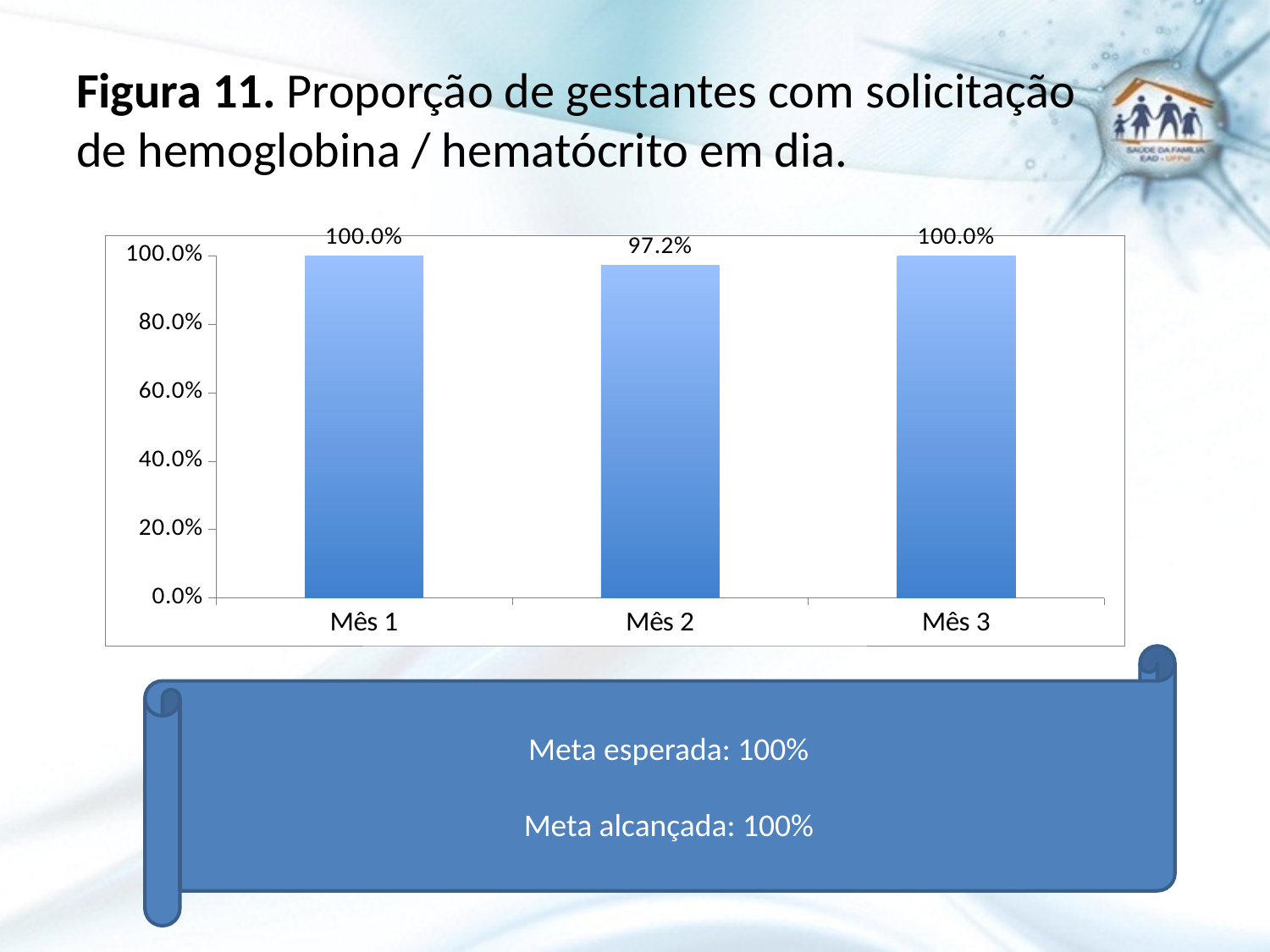
What is the value for Mês 2? 97.2% What is the highest tick value shown on the y axis? 100.0% Which month has the lowest value? Mês 2 Which is larger, the value for Mês 2 or the value for Mês 3? Mês 3 What is the figure number given in the slide title? Figura 11 What is the value for Mês 1? 100.0% Is the value for Mês 2 greater or less than 80.0%? greater What is the value for Mês 3? 100.0% How many months are shown on the x axis? 3 Do the values rise or fall from Mês 1 to Mês 2? fall What is the difference between the values for Mês 1 and Mês 2? 2.8% What kind of chart is shown on the slide? bar chart